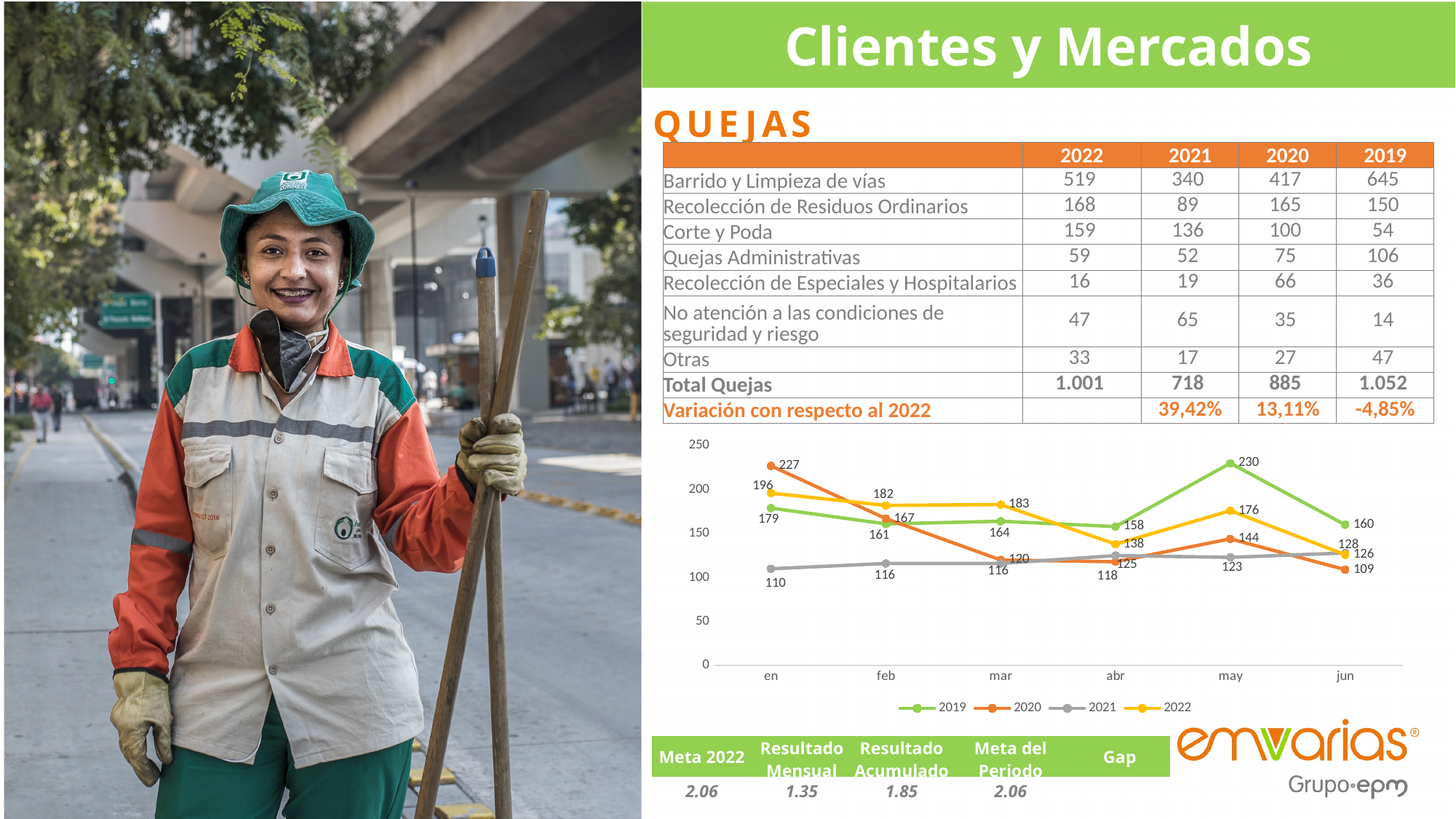
What type of chart is shown on the slide? line chart How many series does the chart legend list? 4 What is the value for the 2022 series in abr? 138 In which month does the 2020 series have its lowest value? jun What is the value for the 2020 series in en? 227 What is the value for the 2019 series in may? 230 Which series has the larger value in feb, 2022 or 2021? 2022 In which month does the 2019 series reach its highest value? may How many months are plotted along the x axis of the chart? 6 What is the value for the 2021 series in jun? 128 What is the difference between the 2020 value in en and the 2020 value in jun? 118 Does the 2021 series rise or fall from en to jun? rise